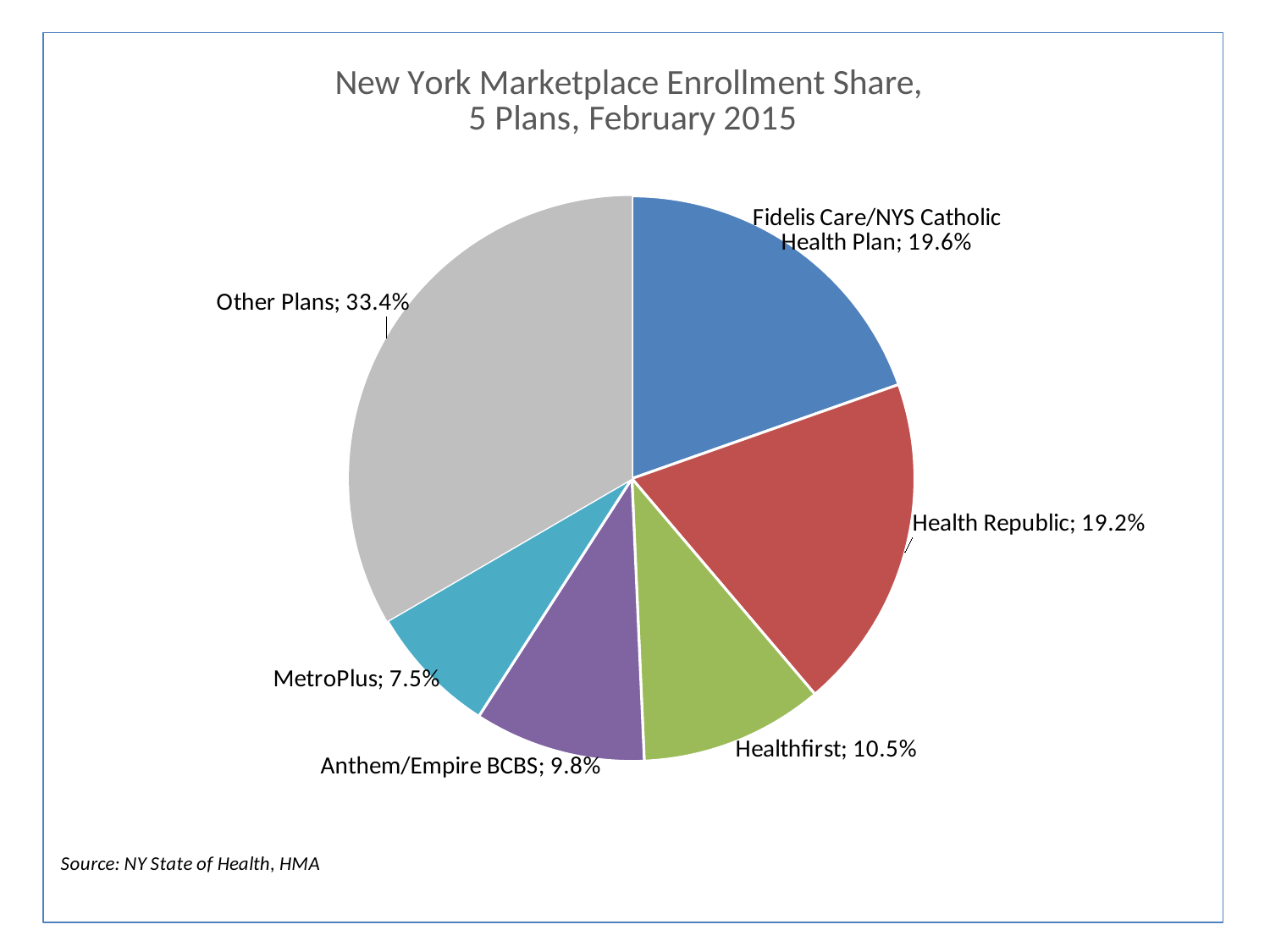
What is the title of the chart? New York Marketplace Enrollment Share, 5 Plans, February 2015 What is the enrollment share for Health Republic? 19.2% What is the enrollment share for Anthem/Empire BCBS? 9.8% What is the difference between the shares of Healthfirst and Anthem/Empire BCBS? 0.7% How many slices does the pie chart have? 6 What is the source cited for the chart? NY State of Health, HMA Which slice has the largest share of the pie? Other Plans Which slice has the smallest share of the pie? MetroPlus What kind of chart is shown on the slide? pie chart Which has a larger share, Healthfirst or MetroPlus? Healthfirst What is the enrollment share for MetroPlus? 7.5% What is the enrollment share for Fidelis Care/NYS Catholic Health Plan? 19.6%